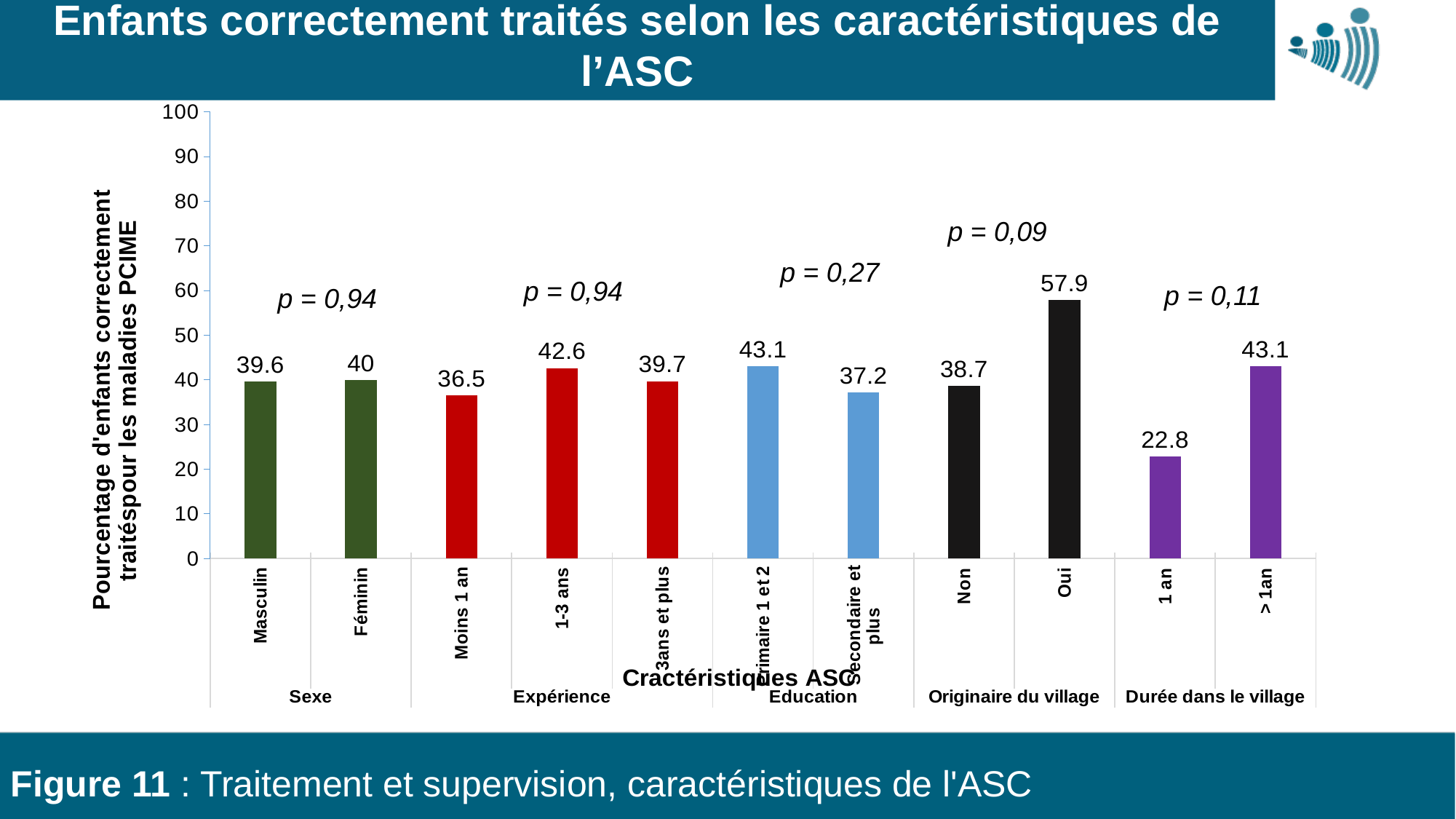
What kind of chart is shown on the slide? Bar chart What is the value for 1 an under Durée dans le village? 22.8 Which is larger, the value for 1-3 ans or the value for Moins 1 an? 1-3 ans What is the difference between the values for Oui and Non under Originaire du village? 19.2 How many bars are plotted in the chart? 11 What is the difference between the values for > 1an and 1 an under Durée dans le village? 20.3 What is the value for Secondaire et plus? 37.2 Which category has the lowest value? 1 an What is the value for Oui under Originaire du village? 57.9 Which category has the highest value? Oui What p-value is shown above the Originaire du village group? p = 0,09 What is the value for Masculin? 39.6